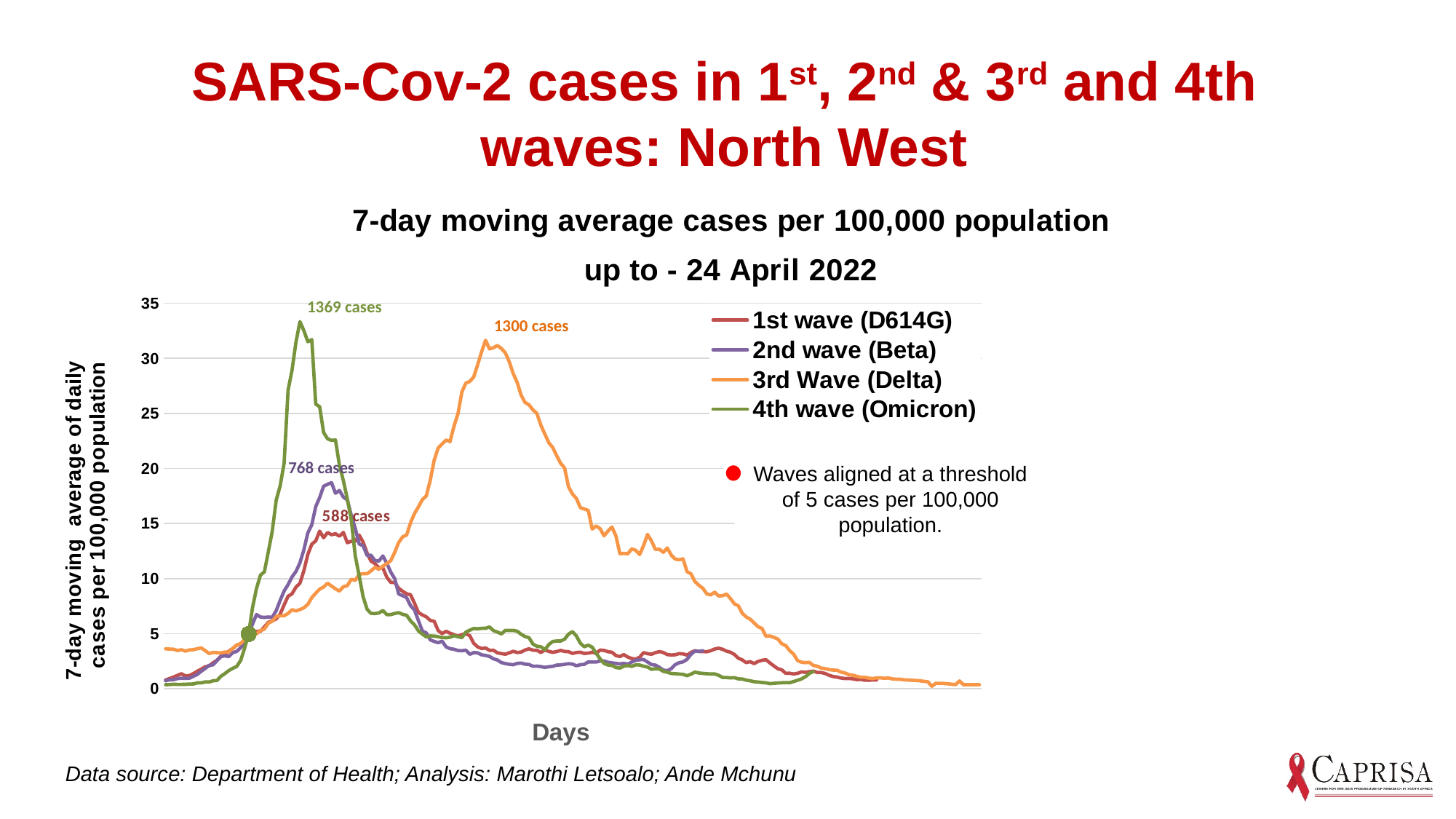
Is the peak value of the 1st wave (D614G) greater or less than 15 cases per 100,000 population? less How many cases are labelled at the peak of the 4th wave (Omicron)? 1369 cases How many cases are labelled at the peak of the 3rd Wave (Delta)? 1300 cases What is the difference between the labelled peak case counts of the 4th wave (1369 cases) and the 3rd wave (1300 cases)? 69 cases Which wave has the lowest peak in 7-day moving average cases per 100,000 population? 1st wave (D614G) At what threshold of cases per 100,000 population are the waves aligned, according to the note on the chart? 5 cases per 100,000 population Is the peak value of the 4th wave (Omicron) greater or less than 30 cases per 100,000 population? greater What kind of chart is shown on the slide? Line chart How many series does the legend list? 4 How many cases are labelled at the peak of the 2nd wave (Beta)? 768 cases How many cases are labelled at the peak of the 1st wave (D614G)? 588 cases Which wave reaches the highest peak in 7-day moving average cases per 100,000 population? 4th wave (Omicron)